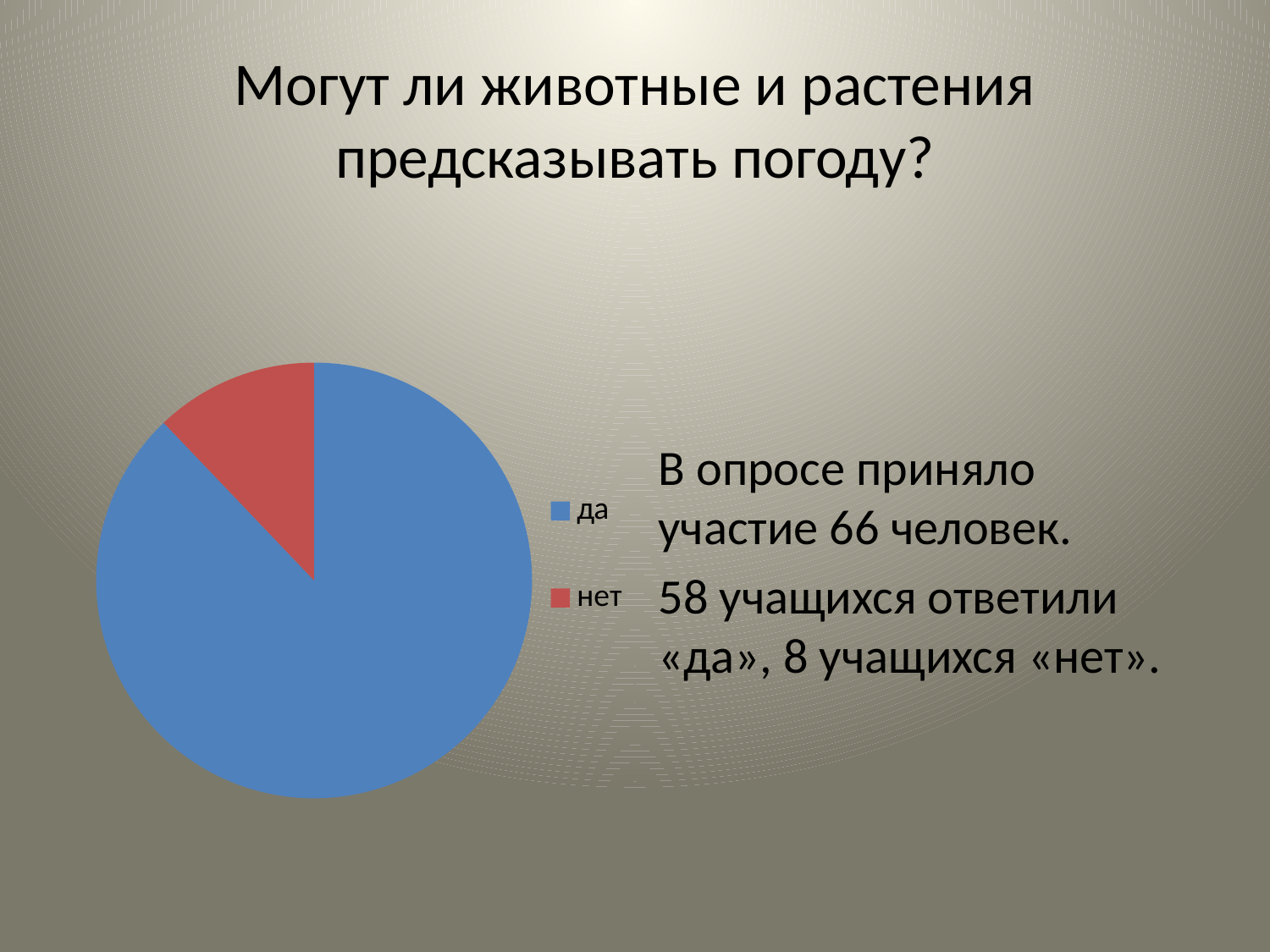
What kind of chart is shown on the slide? pie chart What is the difference between the number of "да" answers and "нет" answers stated on the slide? 50 What colour is the "да" slice in the pie chart? blue Which category has the largest slice in the pie chart? да How many slices does the pie chart have? 2 Which slice is larger in the pie chart, "да" or "нет"? да According to the slide, how many students answered "да"? 58 According to the slide, how many people took part in the survey in total? 66 How many entries does the legend of the pie chart list? 2 What is the title of the slide containing the pie chart? Могут ли животные и растения предсказывать погоду? According to the slide, how many students answered "нет"? 8 Which category has the smallest slice in the pie chart? нет